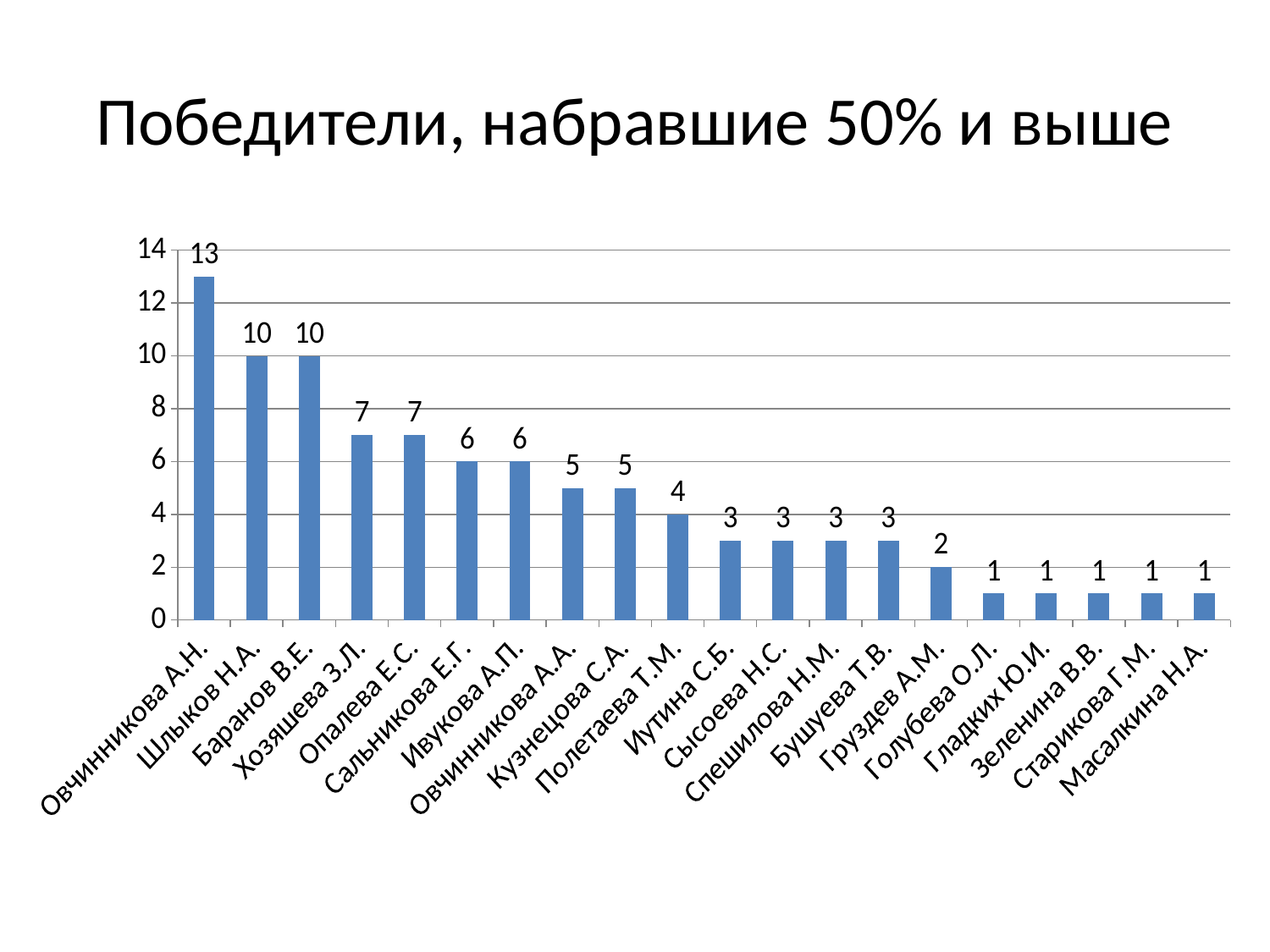
Which category has the highest value? Овчинникова А.Н. What is the value for Полетаева Т.М.? 4 How many categories are shown on the x axis? 20 What is the difference between the values for Хозяшева З.Л. and Полетаева Т.М.? 3 What is the value for Сальникова Е.Г.? 6 What kind of chart is shown on the slide? Bar chart Is the value for Опалева Е.С. greater or less than 4? greater What is the difference between the values for Овчинникова А.Н. and Шлыков Н.А.? 3 What is the title of the chart? Победители, набравшие 50% и выше Which is larger, the value for Баранов В.Е. or the value for Кузнецова С.А.? Баранов В.Е. What is the value for Груздев А.М.? 2 What is the value for Овчинникова А.Н.? 13